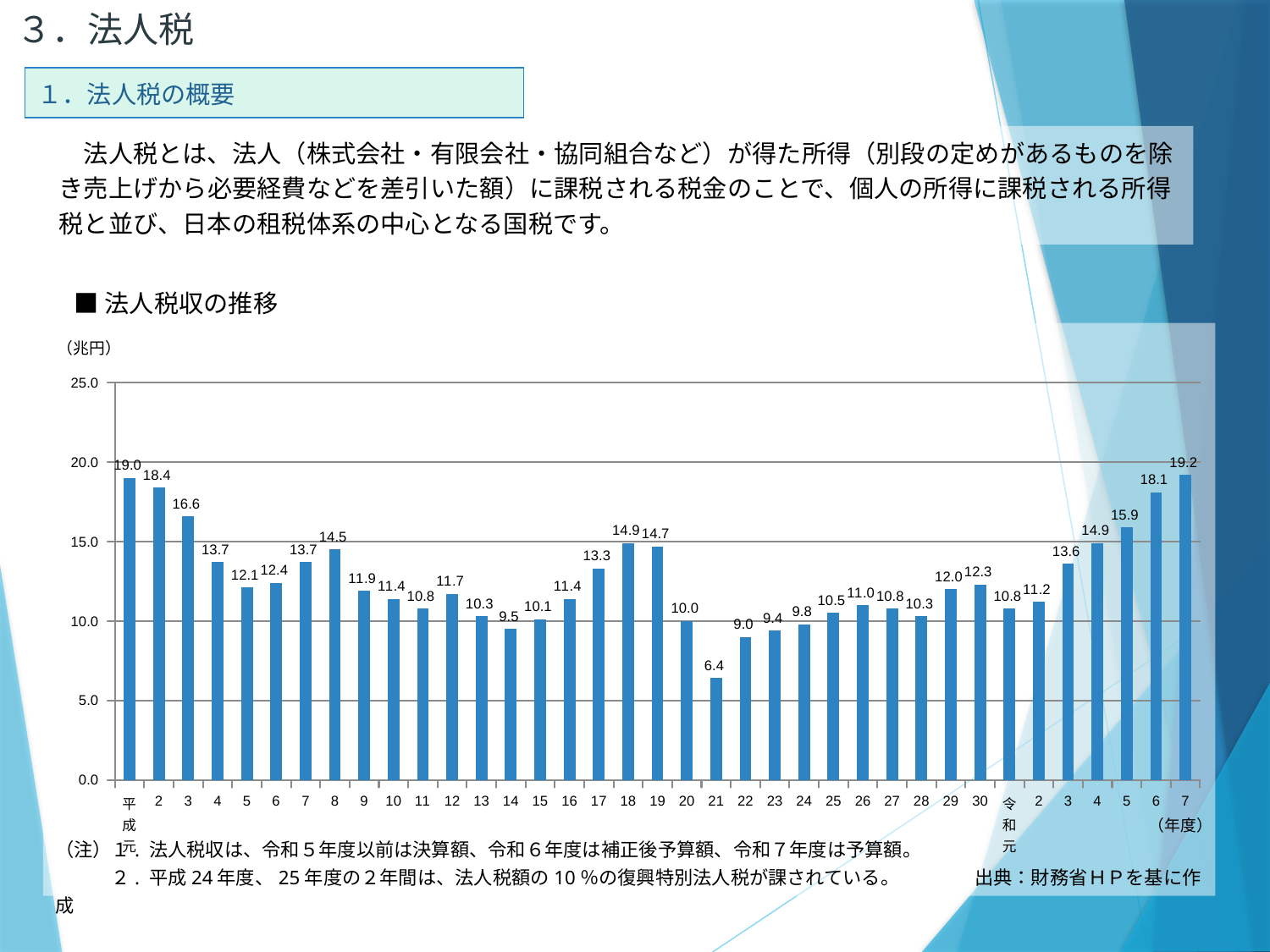
「法人税収の推移」のグラフで、平成18年度の法人税収はいくらですか？ 14.9 「法人税収の推移」のグラフで、法人税収が最も低い年度はどれですか？ 平成21年度 「法人税収の推移」のグラフで、平成20年度の法人税収は15.0より大きいですか、小さいですか？ 小さい 「法人税収の推移」のグラフで、令和7年度と令和6年度の法人税収の差はいくらですか？ 1.1 「法人税収の推移」のグラフには、何年度分の棒がありますか？ 37 「法人税収の推移」のグラフで、平成元年度と平成21年度の法人税収の差はいくらですか？ 12.6 「法人税収の推移」のグラフで、令和元年度から令和7年度にかけて法人税収は増加していますか、減少していますか？ 増加 「法人税収の推移」のグラフはどの種類のグラフですか？ 棒グラフ 「法人税収の推移」のグラフで、平成21年度の法人税収はいくらですか？ 6.4 「法人税収の推移」のグラフで、平成3年度と令和5年度では、どちらの法人税収が大きいですか？ 平成3年度 「法人税収の推移」のグラフで、法人税収が最も高い年度はどれですか？ 令和7年度 「法人税収の推移」のグラフで、令和7年度の法人税収はいくらですか？ 19.2